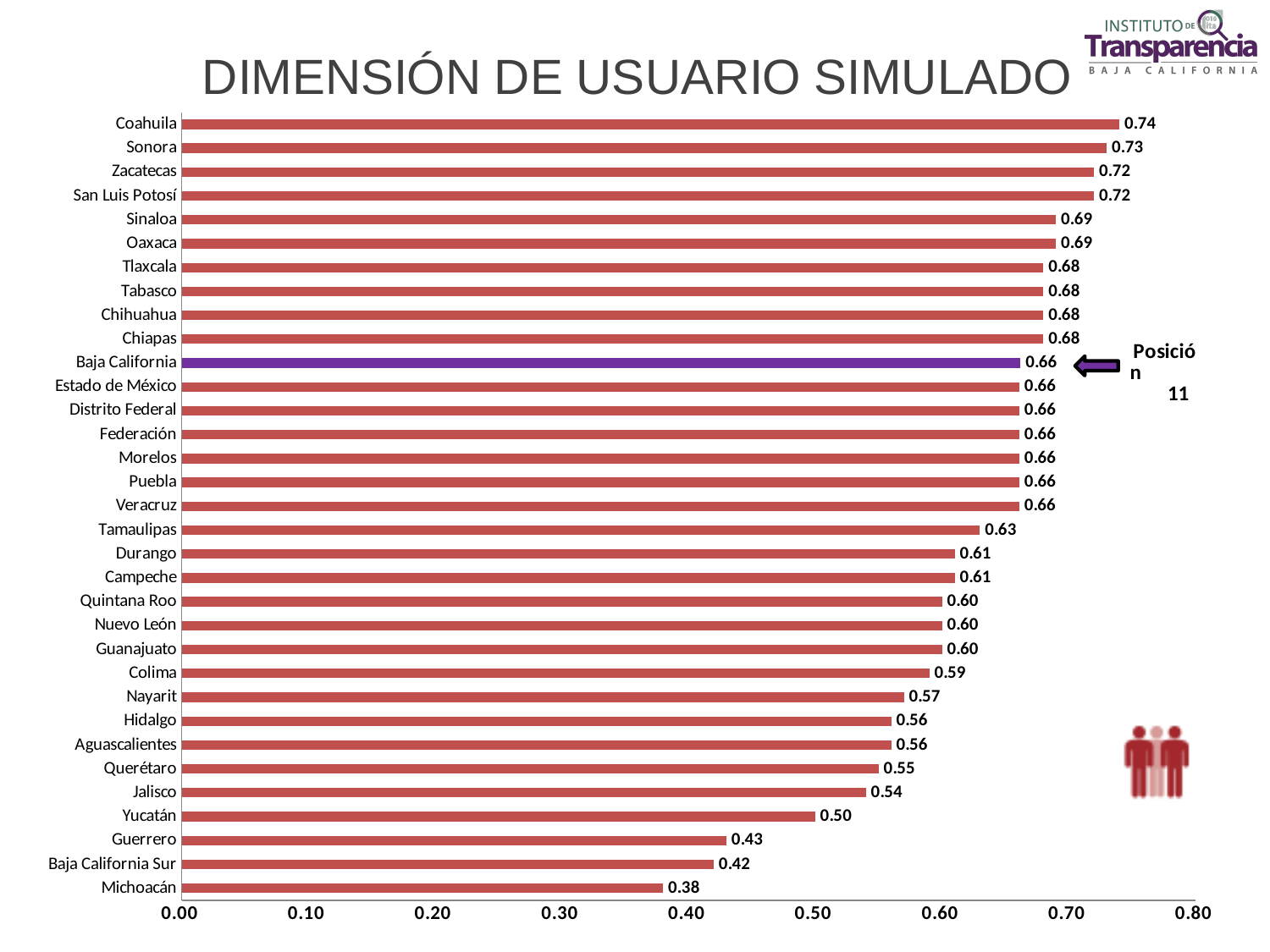
What is the value for Michoacán? 0.38 Is the value for Jalisco greater or less than 0.60? less How many categories are shown in the chart? 33 Which category has the highest value? Coahuila What is the value for Baja California? 0.66 Which category has the lowest value? Michoacán Which is larger, the value for Yucatán or the value for Guerrero? Yucatán What is the value for Tamaulipas? 0.63 Which bar is highlighted in a different colour (purple) from the others? Baja California What is the title of the chart? DIMENSIÓN DE USUARIO SIMULADO What is the difference between the values for Coahuila and Michoacán? 0.36 What kind of chart is shown on the slide? bar chart